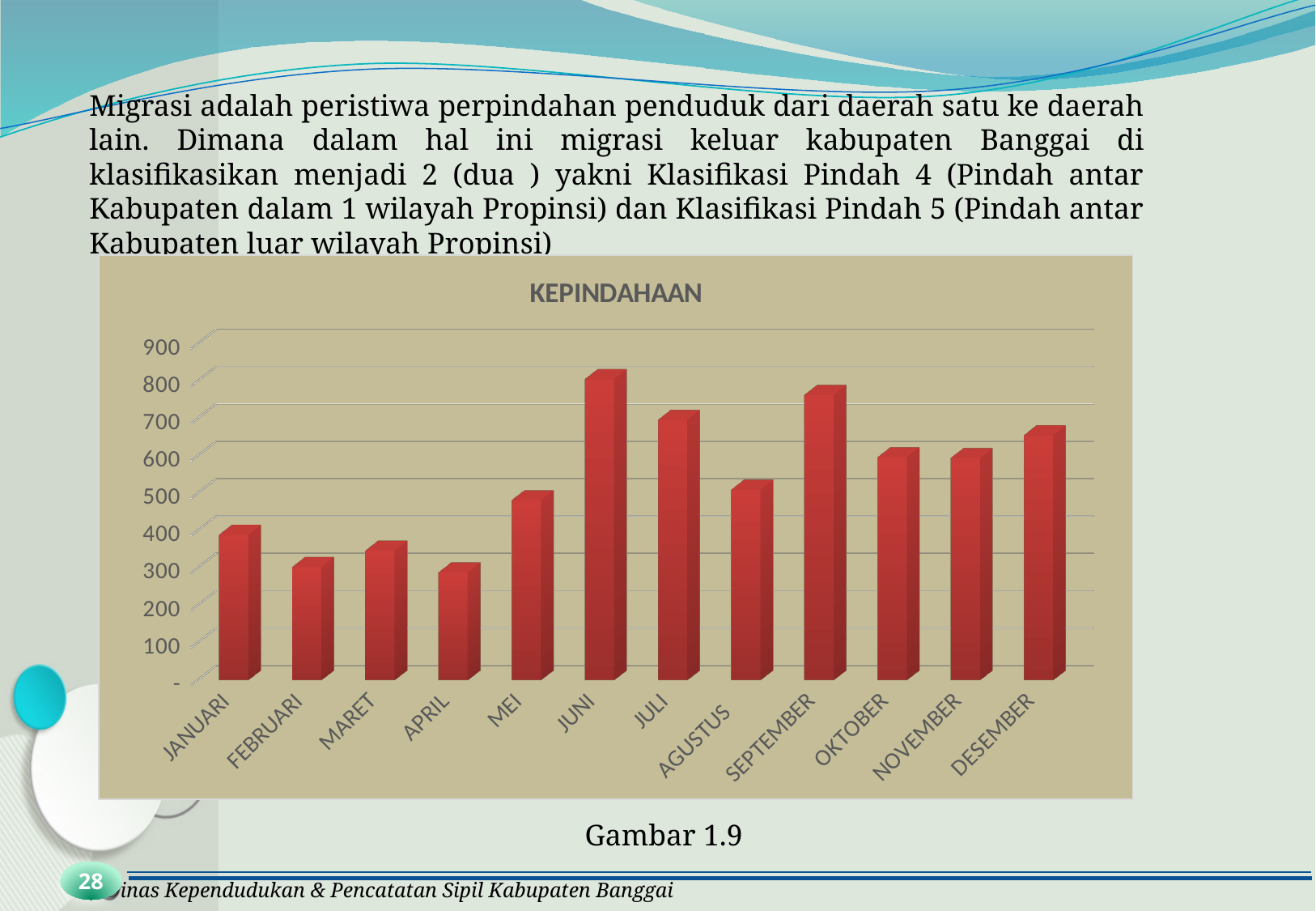
Is the value for MEI greater or less than 600? less Is the value for JANUARI greater or less than 500? less Which is larger, the value for JUNI or the value for JANUARI? JUNI Is the value for JUNI greater or less than 700? greater Which month has the highest value in the chart? JUNI What is the title of the chart? KEPINDAHAAN How many months (categories) are shown on the x axis of the chart? 12 Which is larger, the value for MARET or the value for JULI? JULI What type of chart is shown on the slide? bar chart